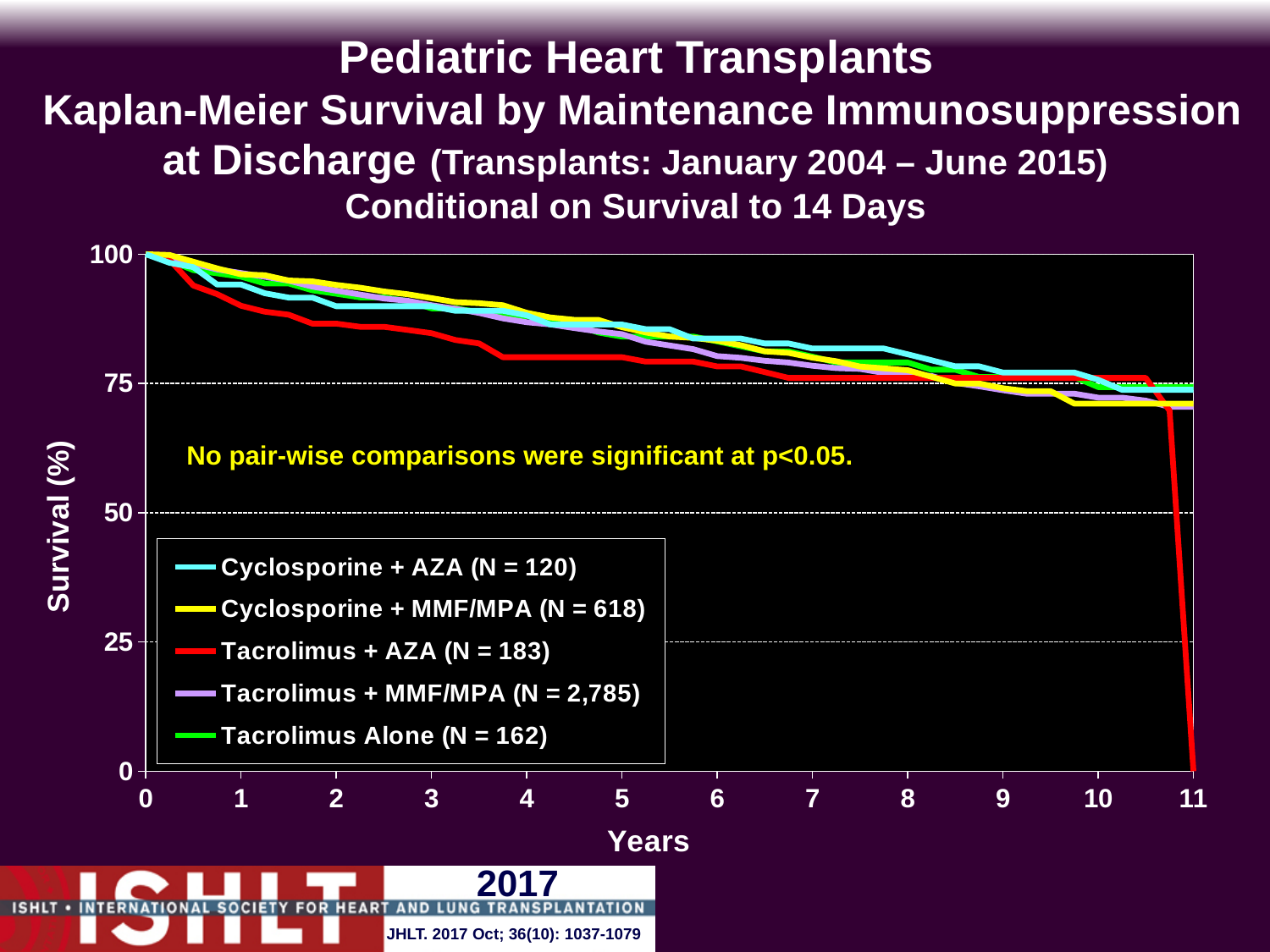
Is the survival value for Tacrolimus + AZA at year 5 greater or less than 75? greater Which group in the legend has the smallest N? Cyclosporine + AZA Is the survival value for Cyclosporine + MMF/MPA at year 10 greater or less than 75? less What is the N for the Tacrolimus + MMF/MPA group shown in the legend? 2,785 Which group has the lowest survival curve at year 2? Tacrolimus + AZA What is the N for the Cyclosporine + AZA group shown in the legend? 120 Which group's curve drops to 0 at year 11? Tacrolimus + AZA Do the survival curves rise or fall as years increase along the x axis? Fall What kind of chart is shown on the slide? Line chart How many series does the legend list? 5 Which group in the legend has the largest N? Tacrolimus + MMF/MPA What is the label on the y axis? Survival (%)